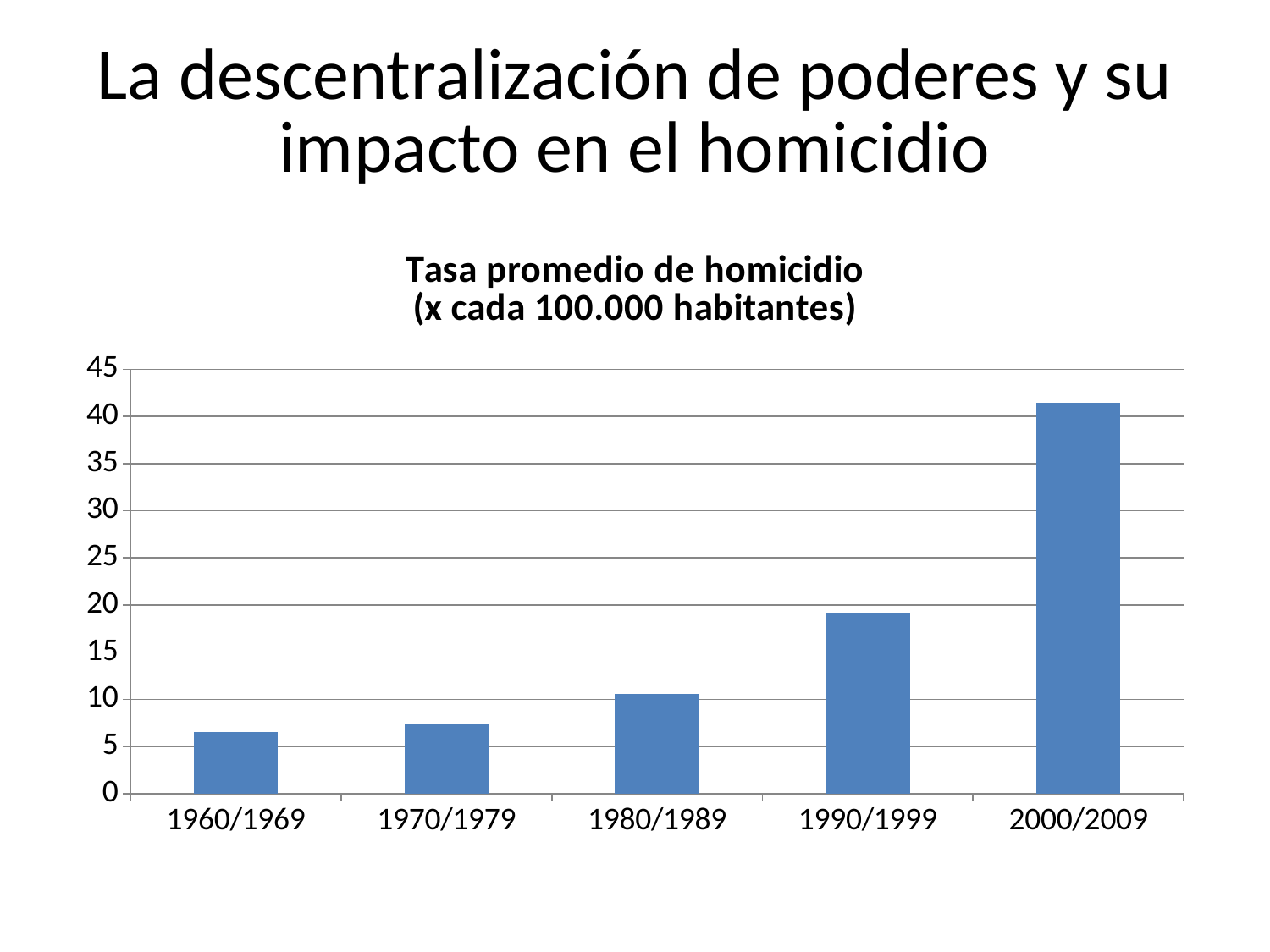
Which is larger, the value for 1990/1999 or the value for 1980/1989? 1990/1999 Is the value for 1990/1999 greater or less than 15? greater Is the value for 1980/1989 greater or less than 15? less Is the value for 2000/2009 greater or less than 35? greater What kind of chart is shown on the slide? bar chart How many decade categories are shown on the x axis? 5 Which is larger, the value for 1960/1969 or the value for 2000/2009? 2000/2009 Which decade has the lowest average homicide rate? 1960/1969 Which decade has the highest average homicide rate? 2000/2009 Do the values rise or fall from 1960/1969 to 2000/2009? rise What is the title of the chart? Tasa promedio de homicidio (x cada 100.000 habitantes)